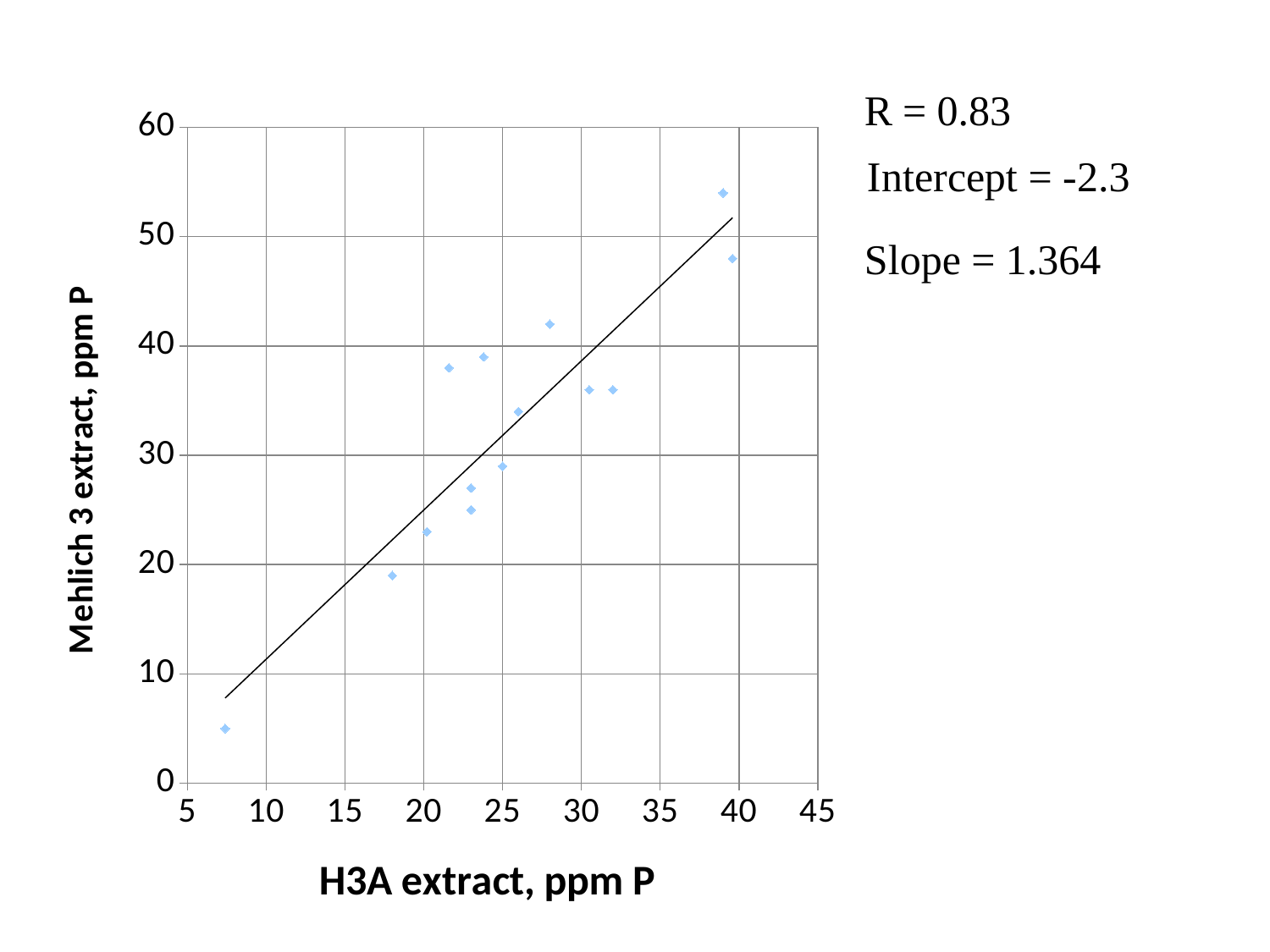
Do the Mehlich 3 extract values generally rise or fall as the H3A extract values increase? rise What is the maximum value shown on the y axis? 60 What is the label of the y axis? Mehlich 3 extract, ppm P How many data points are plotted on the scatter plot? 14 Is the highest Mehlich 3 extract value plotted greater or less than 50? greater What kind of chart is shown on the slide? scatter plot Is the lowest Mehlich 3 extract value plotted greater or less than 10? less What slope is stated on the slide? 1.364 What R value is stated on the slide? 0.83 Is the Mehlich 3 extract value for the point with the largest H3A extract value greater or less than 40? greater What is the label of the x axis? H3A extract, ppm P What intercept is stated on the slide? -2.3